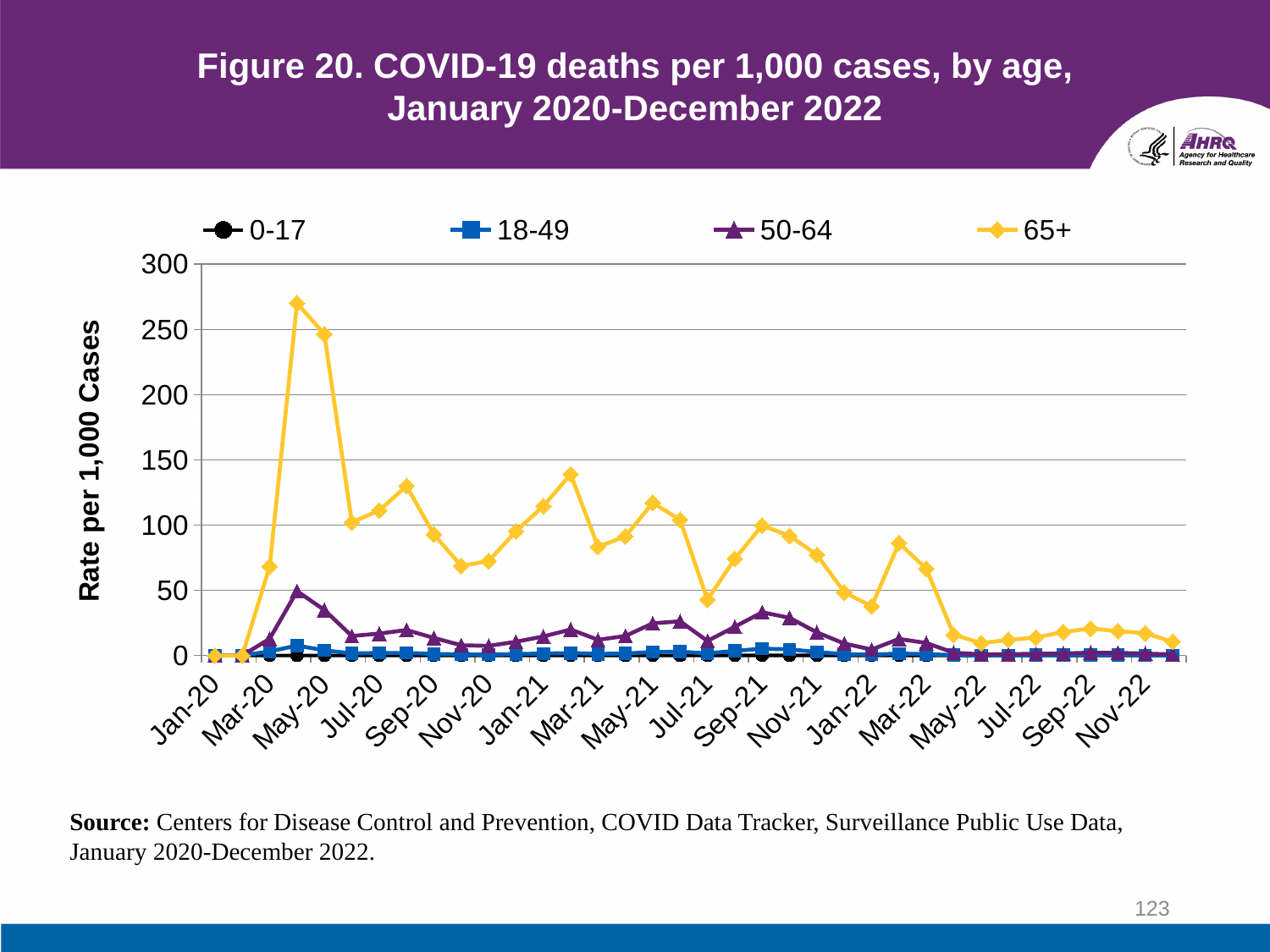
Is the value for the 65+ group in Jan-21 greater or less than 100? greater Is the value for the 65+ group in Jul-21 greater or less than 50? less What kind of chart is shown on the slide? Line chart Is the value for the 65+ group in Jul-22 greater or less than 50? less Which age group has the lowest death rate per 1,000 cases throughout the period? 0-17 How many series does the legend list? 4 Which age group has the highest death rate per 1,000 cases throughout the period? 65+ Does the value for the 65+ group rise or fall from Mar-22 to Nov-22? fall What is the label on the vertical axis? Rate per 1,000 Cases In May-20, which group has the larger value, 65+ or 50-64? 65+